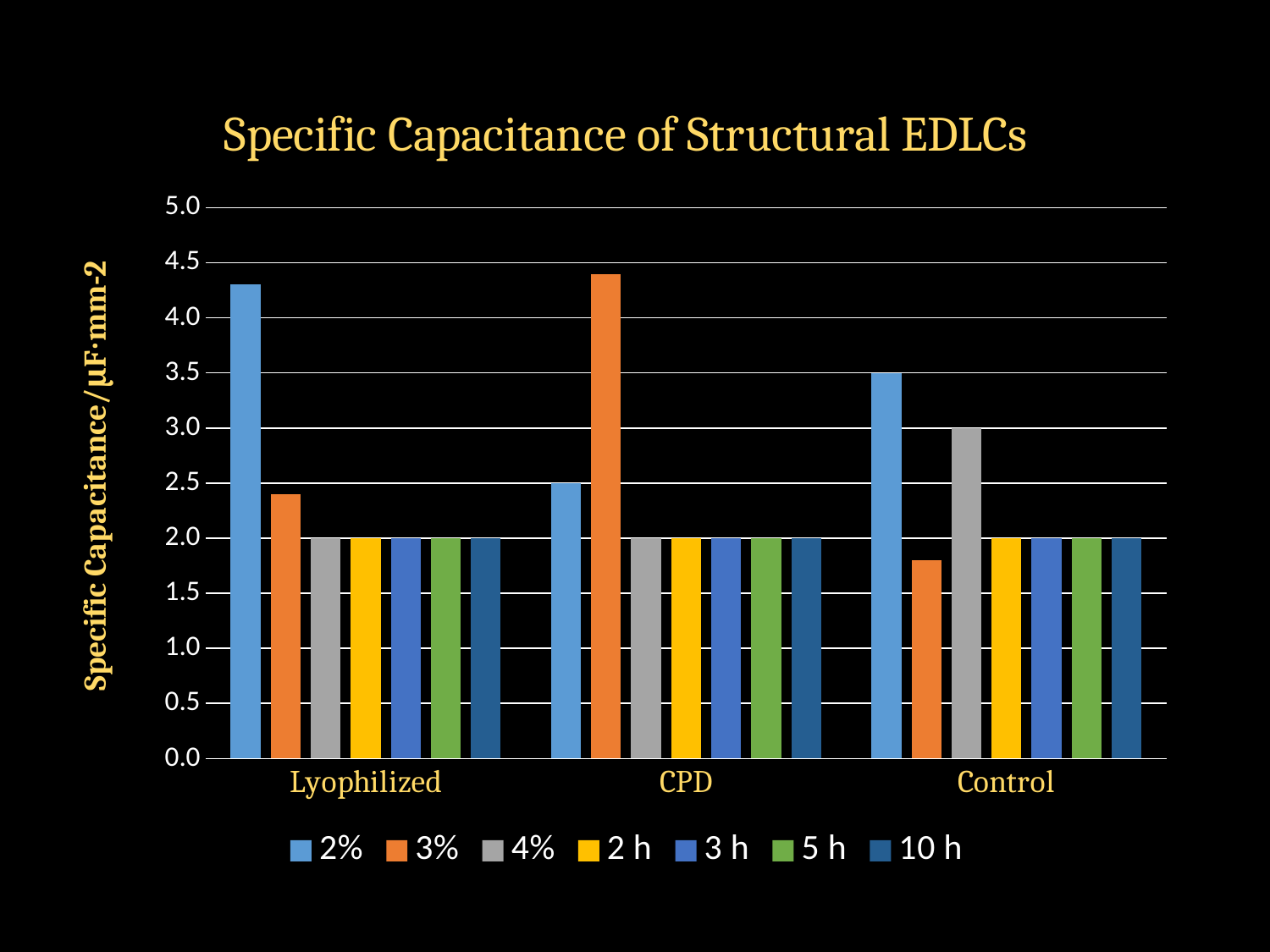
What is the label of the vertical axis? Specific Capacitance/μF·mm-2 Which series has the lowest value for Control? 3% How many categories are shown on the x axis? 3 What is the title of the chart? Specific Capacitance of Structural EDLCs Which series has the highest value for Lyophilized? 2% How many series does the legend list? 7 Is the value of the 3% series for Control greater or less than 2.0? less What is the value of the 4% series for Control? 3.0 What kind of chart is shown on the slide? bar chart Is the value of the 3% series for CPD greater or less than 4.0? greater What is the value of the 2% series for Control? 3.5 What is the value of the 2% series for CPD? 2.5